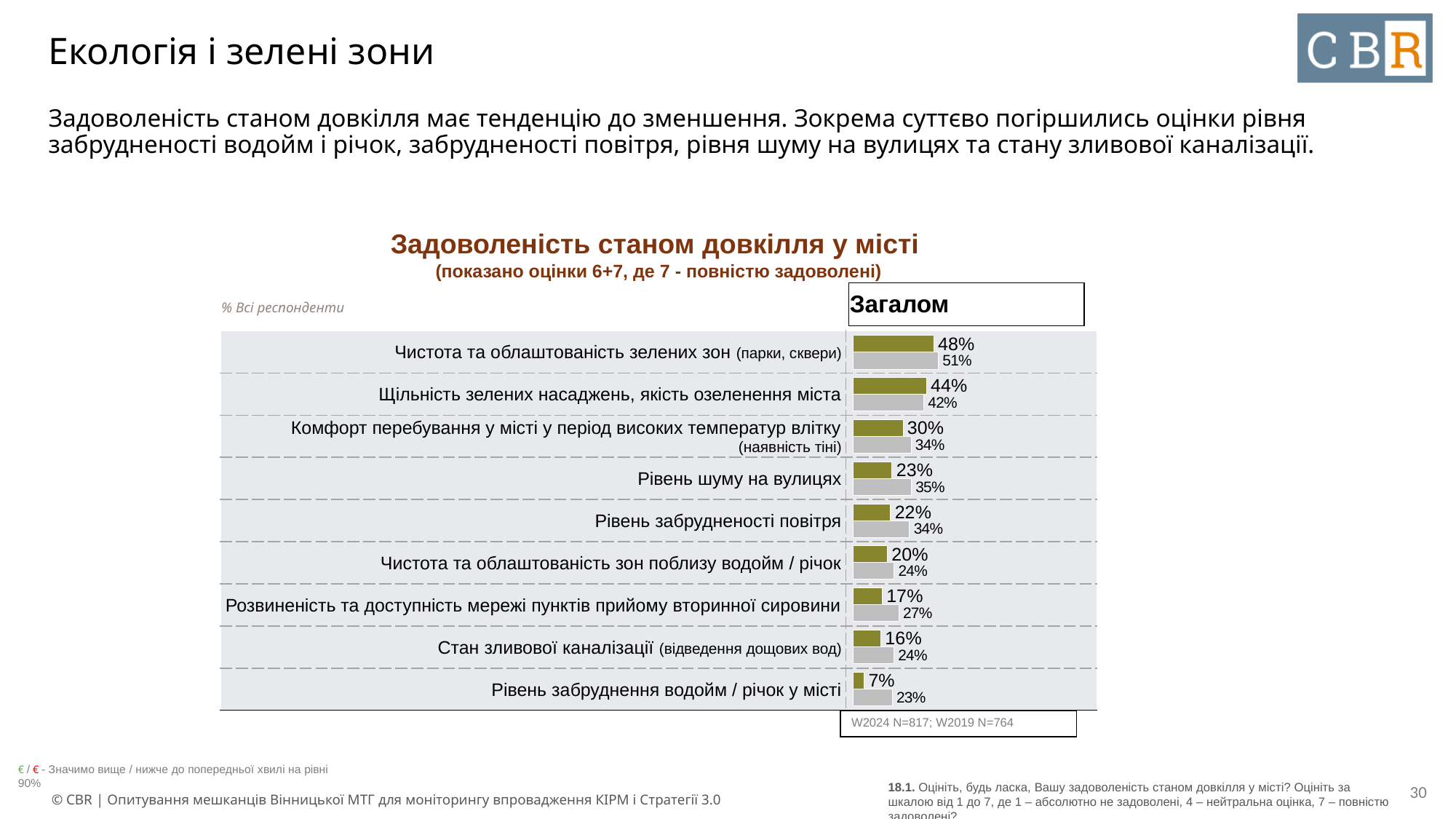
What sample sizes are given in the note below the chart? W2024 N=817; W2019 N=764 What is the difference between the grey bar and the olive-coloured bar for 'Рівень забруднення водойм / річок у місті'? 16% What is the value of the olive-coloured bar for 'Чистота та облаштованість зелених зон (парки, сквери)'? 48% What type of chart is shown on the slide? bar chart What is the title of the chart? Задоволеність станом довкілля у місті For 'Щільність зелених насаджень, якість озеленення міста', which is larger: the olive-coloured bar or the grey bar? the olive-coloured bar What is the value of the olive-coloured bar for 'Рівень забруднення водойм / річок у місті'? 7% Which category has the highest value among the olive-coloured bars? Чистота та облаштованість зелених зон (парки, сквери) How many categories (environmental aspects) are listed in the chart? 9 What is the value of the grey bar for 'Рівень шуму на вулицях'? 35% Which category has the lowest value among the olive-coloured bars? Рівень забруднення водойм / річок у місті What is the difference between the grey bar and the olive-coloured bar for 'Рівень забрудненості повітря'? 12%